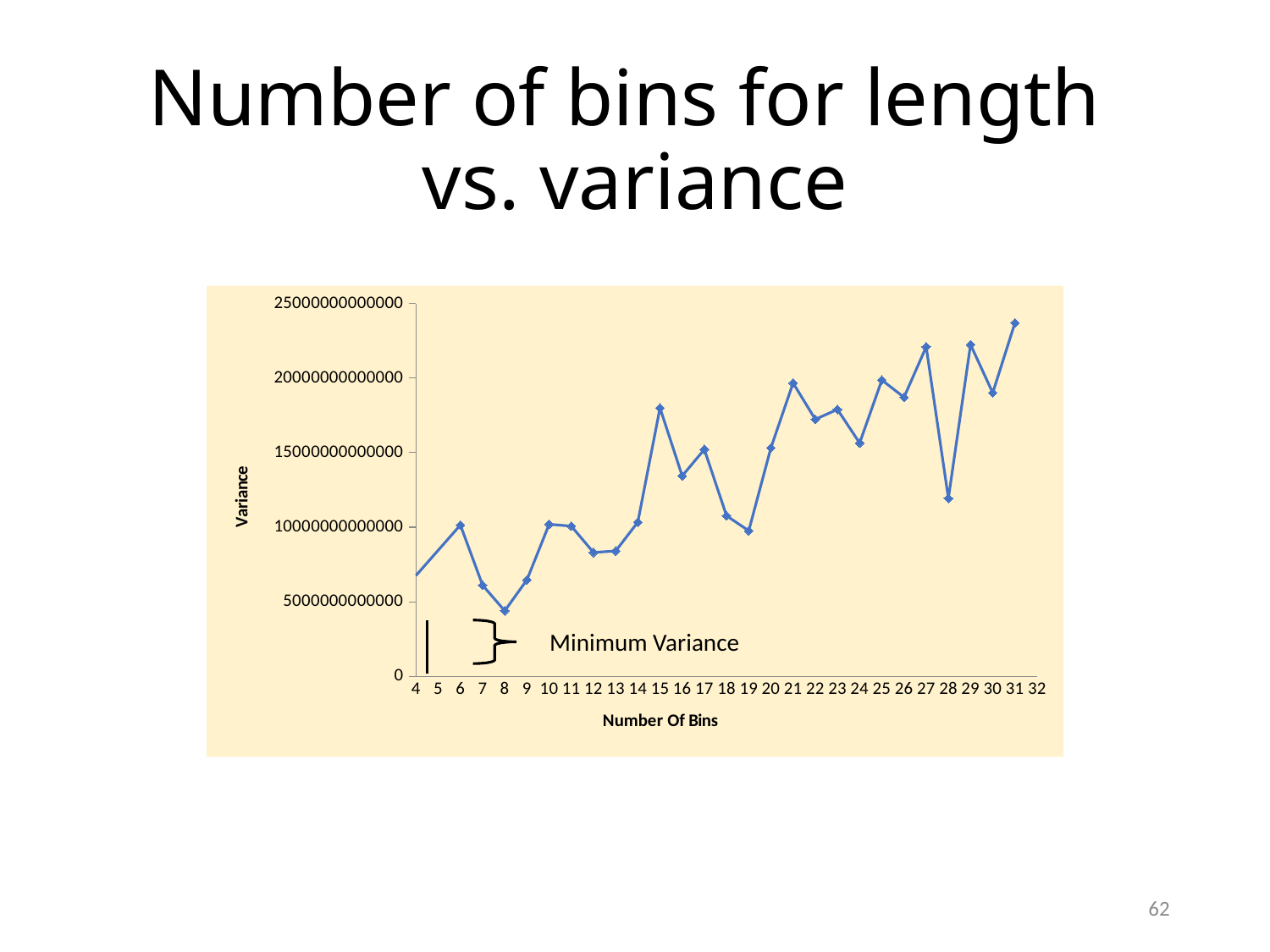
What is the title of the chart on the slide? Number of bins for length vs. variance Is the variance at 28 bins greater or less than 150000000000000? less What kind of chart is shown on the slide? line chart Which has the larger variance, 15 bins or 16 bins? 15 bins At which number of bins is the variance lowest? 8 What is the label of the x axis? Number Of Bins Is the variance at 31 bins greater or less than 200000000000000? greater Is the variance at 15 bins greater or less than 150000000000000? greater At which number of bins is the variance highest? 31 Overall, does the variance rise or fall as the number of bins increases? rises Which has the larger variance, 27 bins or 28 bins? 27 bins